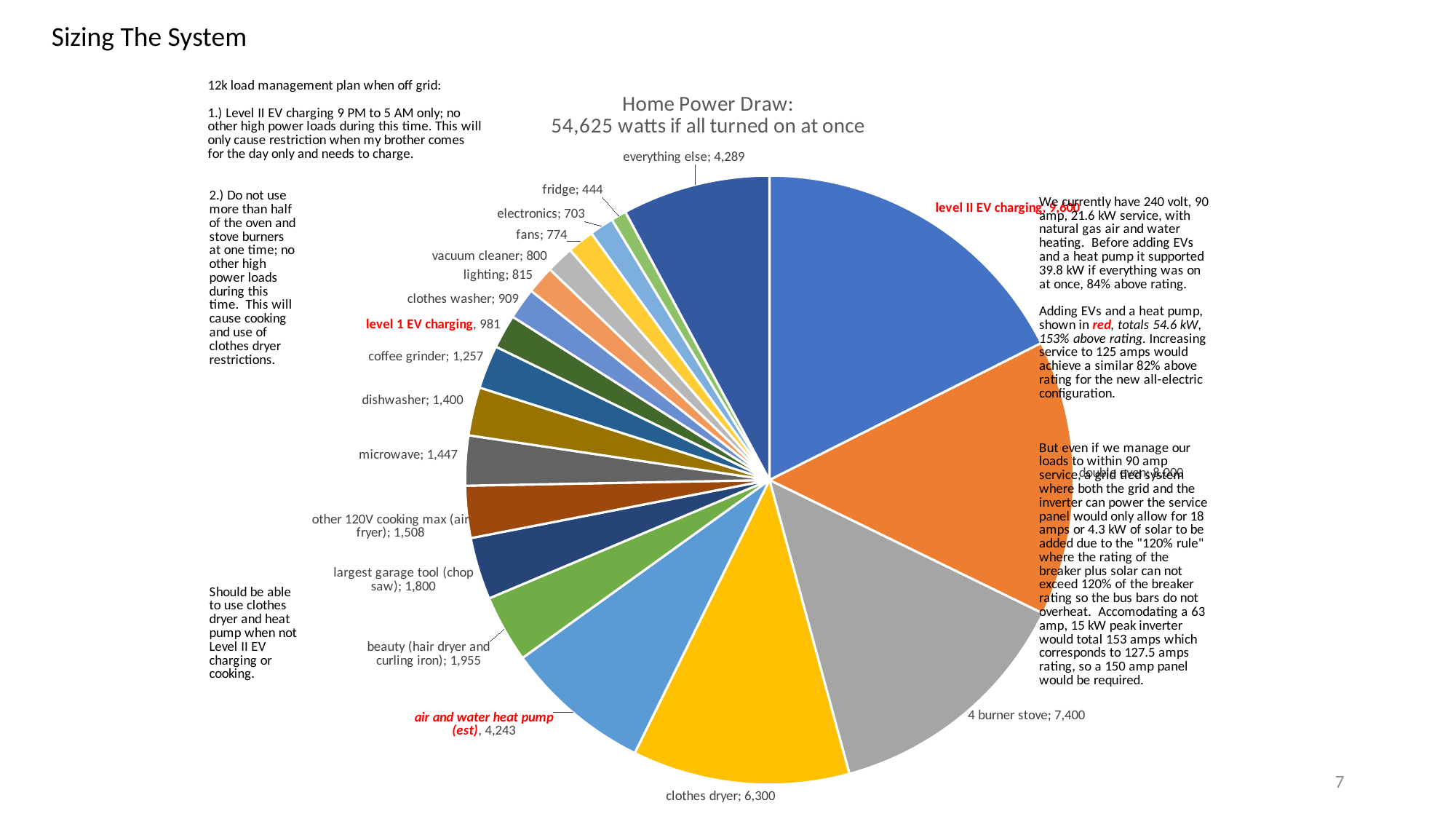
What is the value shown for the air and water heat pump (est)? 4,243 What is the value shown for the 4 burner stove? 7,400 Which category has the smallest slice in the pie chart? fridge What is the difference between the beauty (hair dryer and curling iron) value and the largest garage tool (chop saw) value? 155 What is the power draw value shown for level II EV charging? 9,600 What is the value shown for the fridge? 444 What is the title of the chart? Home Power Draw: 54,625 watts if all turned on at once What kind of chart is shown on the slide? pie chart Which is larger, the value for the microwave or the value for the dishwasher? microwave Which category has the largest slice in the pie chart? level II EV charging What is the difference between the 4 burner stove value and the clothes dryer value? 1,100 What is the value shown for the clothes dryer slice? 6,300